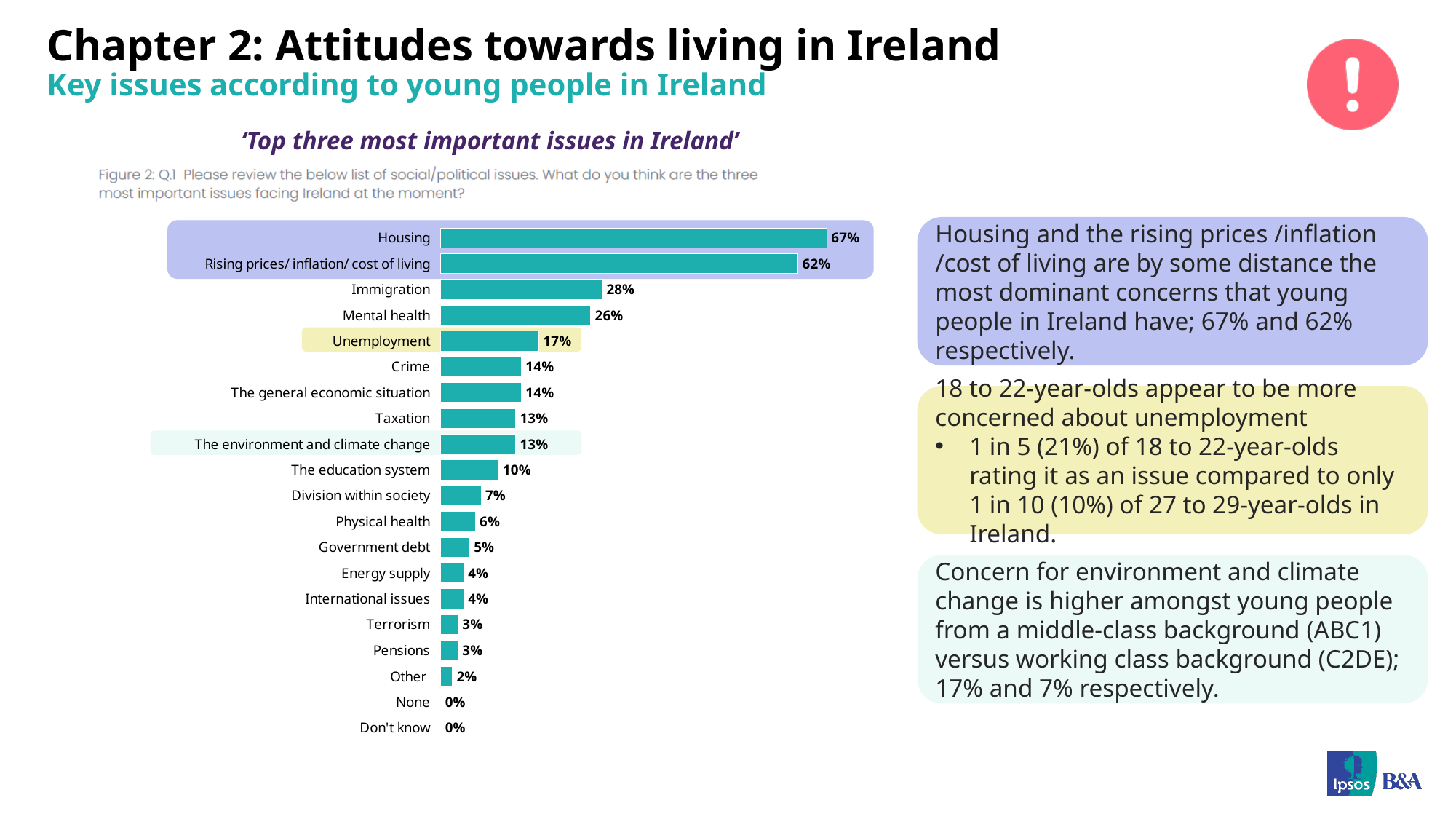
What is the difference in percentage points between Immigration and Unemployment? 11 What is the value shown for Rising prices/ inflation/ cost of living? 62% What value is shown for The environment and climate change? 13% Which issue has the highest percentage in the chart? Housing How many issue categories are listed in the chart? 20 Which category's label is highlighted in yellow in the chart? Unemployment Which has a higher value, The education system or Division within society? The education system What is the difference in percentage points between Housing and Rising prices/ inflation/ cost of living? 5 What percentage is shown for Mental health? 26% What type of chart is used to show the top three most important issues in Ireland? Bar chart Which has a higher value, Immigration or Mental health? Immigration What percentage of young people selected Housing as one of the top three most important issues in Ireland? 67%